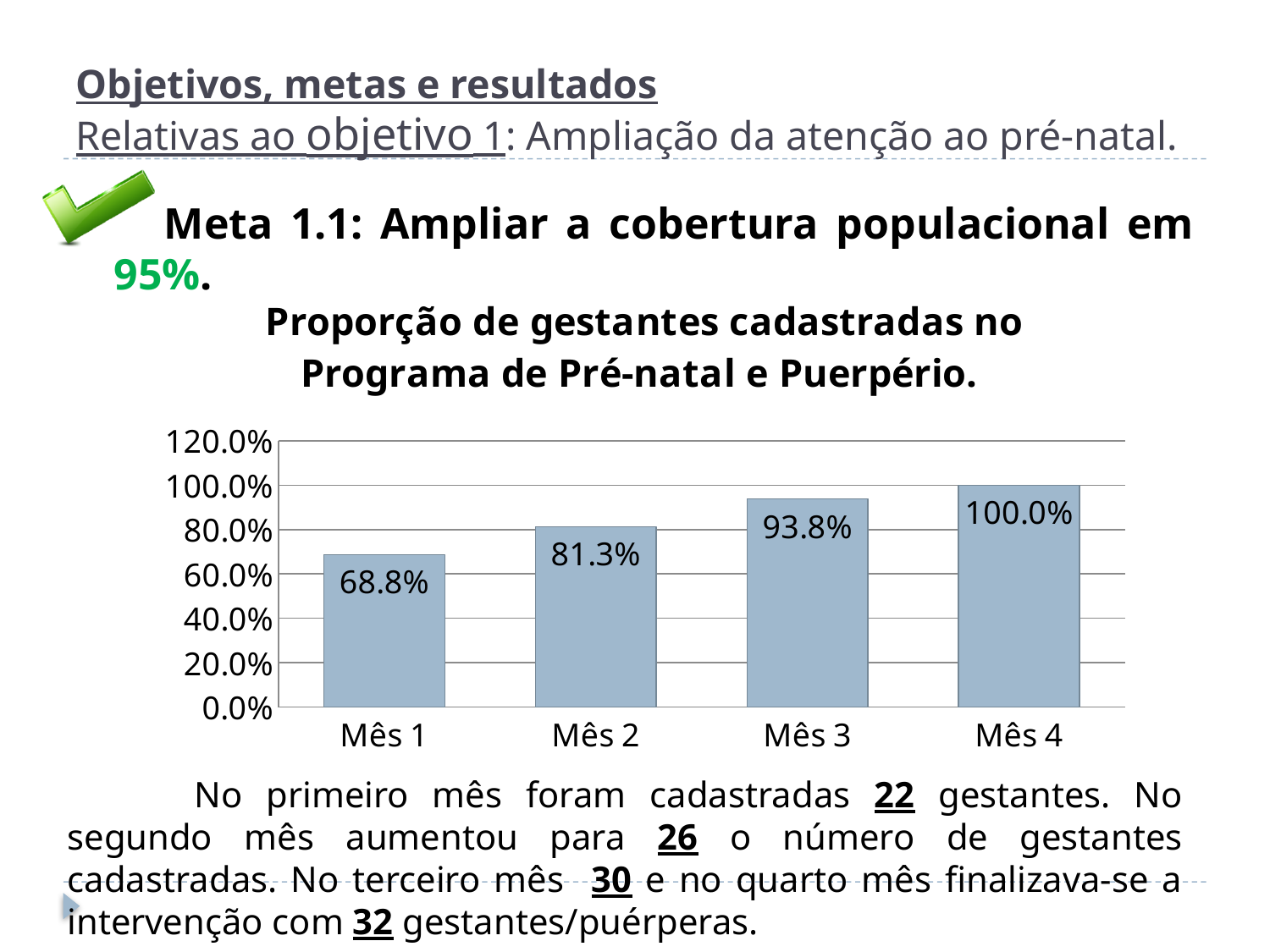
Which is larger, the value for Mês 2 or the value for Mês 3? Mês 3 Is the value for Mês 2 greater or less than 80.0%? greater How many months are shown on the x axis? 4 What is the value for Mês 4? 100.0% What is the difference between the values for Mês 4 and Mês 3? 6.2% What is the value for Mês 1? 68.8% What kind of chart is shown on the slide? bar chart Which month has the lowest value? Mês 1 What is the value for Mês 3? 93.8% What is the difference between the values for Mês 2 and Mês 1? 12.5% Do the values rise or fall from Mês 1 to Mês 4? rise Which month has the highest value? Mês 4